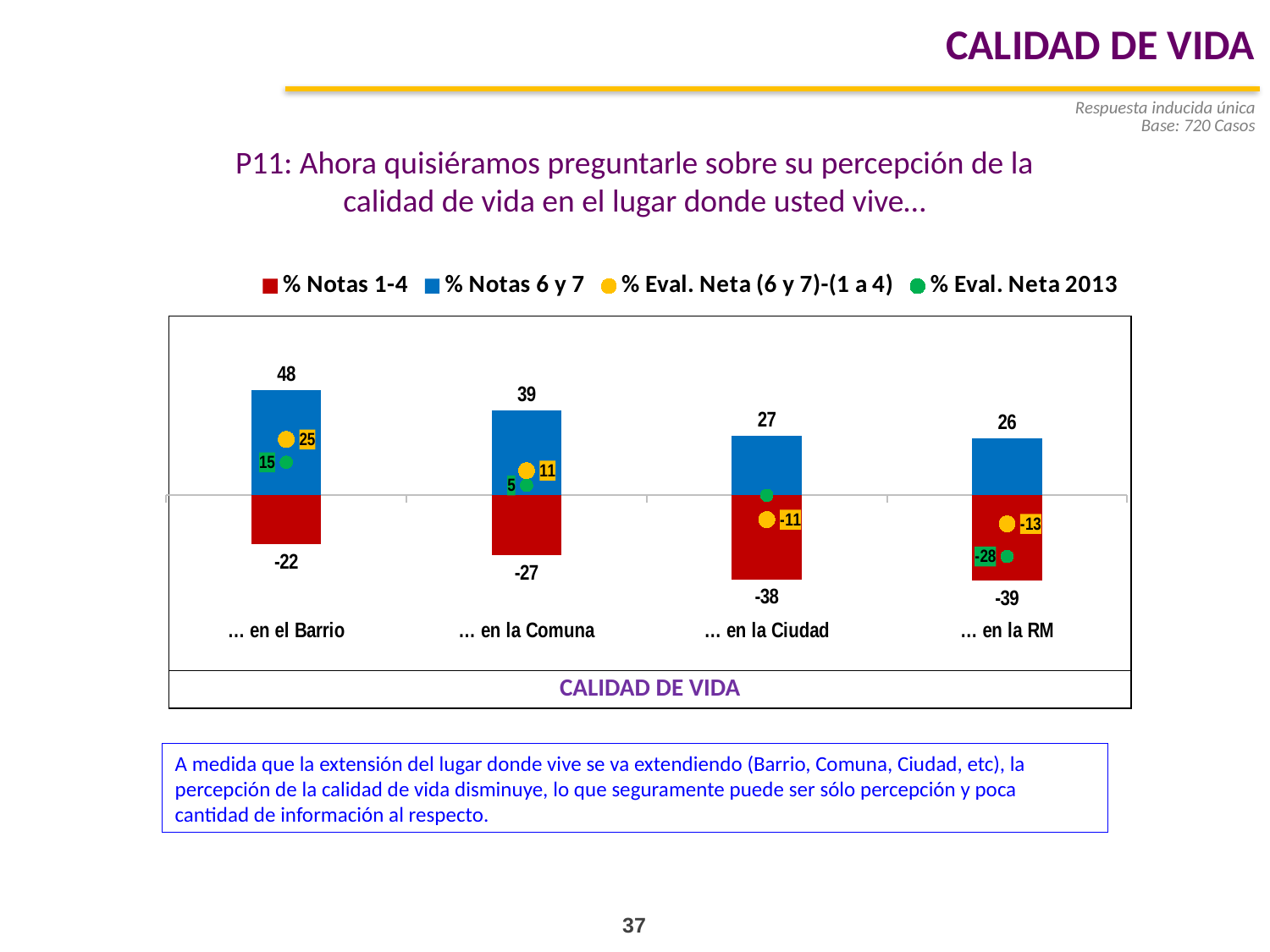
What is the difference between the % Notas 6 y 7 values for "… en el Barrio" and "… en la Comuna"? 9 How many categories are shown on the x axis of the chart? 4 Which is larger, the % Eval. Neta 2013 value for "… en el Barrio" or for "… en la Comuna"? … en el Barrio What is the value of % Eval. Neta 2013 for "… en la RM"? -28 What is the value of % Eval. Neta (6 y 7)-(1 a 4) for "… en la Comuna"? 11 What is the value of % Notas 1-4 for "… en la Ciudad"? -38 How many series does the chart legend list? 4 What kind of chart is shown on the slide? bar chart Do the % Notas 6 y 7 values rise or fall from "… en el Barrio" to "… en la RM"? fall Which category has the lowest value for % Eval. Neta (6 y 7)-(1 a 4)? … en la RM What is the value of % Notas 6 y 7 for "… en el Barrio"? 48 Which category has the highest value for % Notas 6 y 7? … en el Barrio